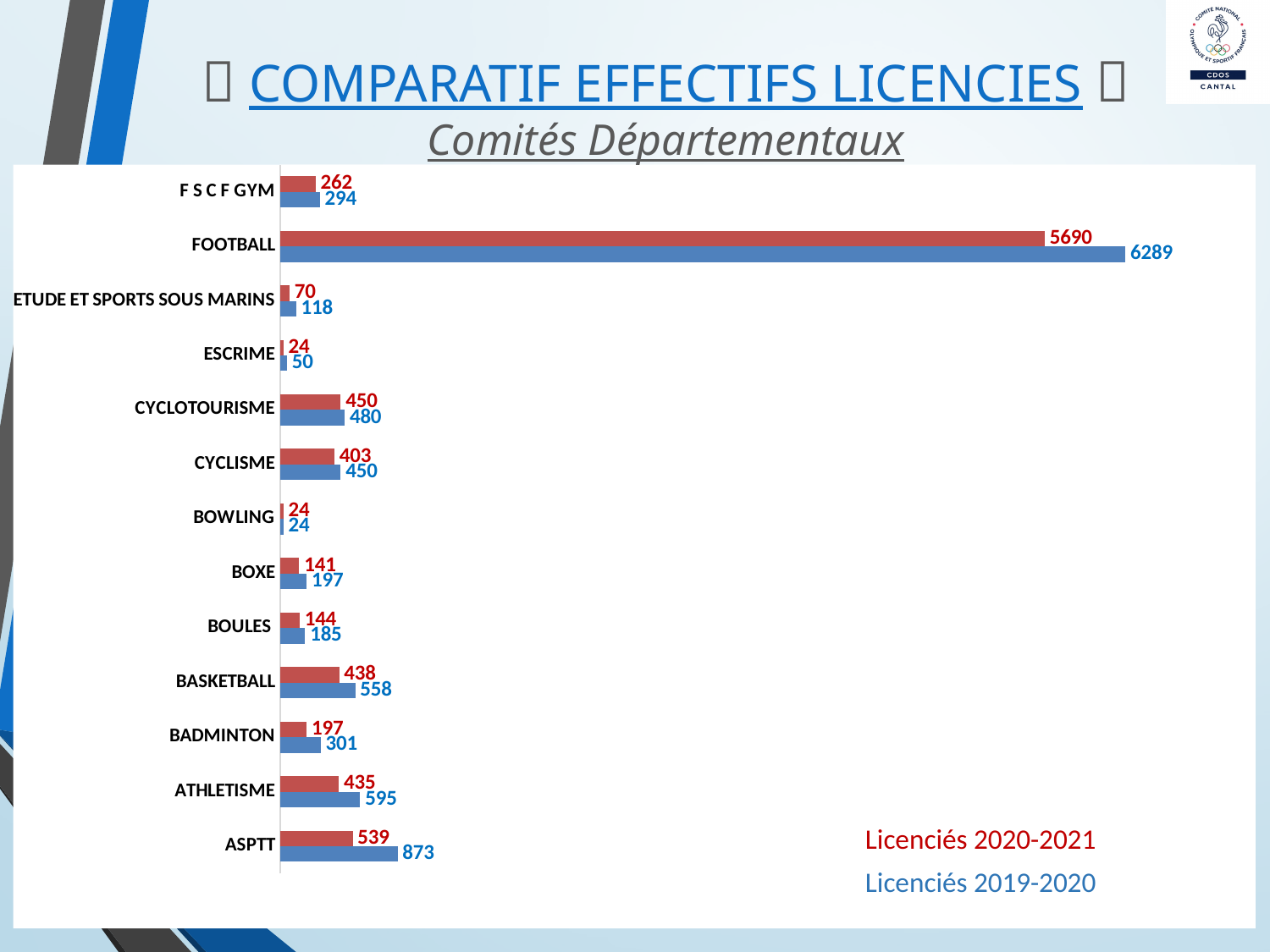
What kind of chart is shown on the slide? bar chart What is the value for FOOTBALL in the Licenciés 2019-2020 series? 6289 What is the difference between the Licenciés 2019-2020 and Licenciés 2020-2021 values for ATHLETISME? 160 How many series does the legend list? 2 What is the difference between the Licenciés 2019-2020 and Licenciés 2020-2021 values for FOOTBALL? 599 What is the value for ASPTT in the Licenciés 2020-2021 series? 539 Which is larger for BASKETBALL: the Licenciés 2020-2021 value or the Licenciés 2019-2020 value? Licenciés 2019-2020 Which category has the highest value in the Licenciés 2020-2021 series? FOOTBALL How many categories are plotted on the chart? 13 What is the value for BADMINTON in the Licenciés 2019-2020 series? 301 What is the subtitle shown under the chart title? Comités Départementaux Which category has the lowest value in the Licenciés 2019-2020 series? BOWLING